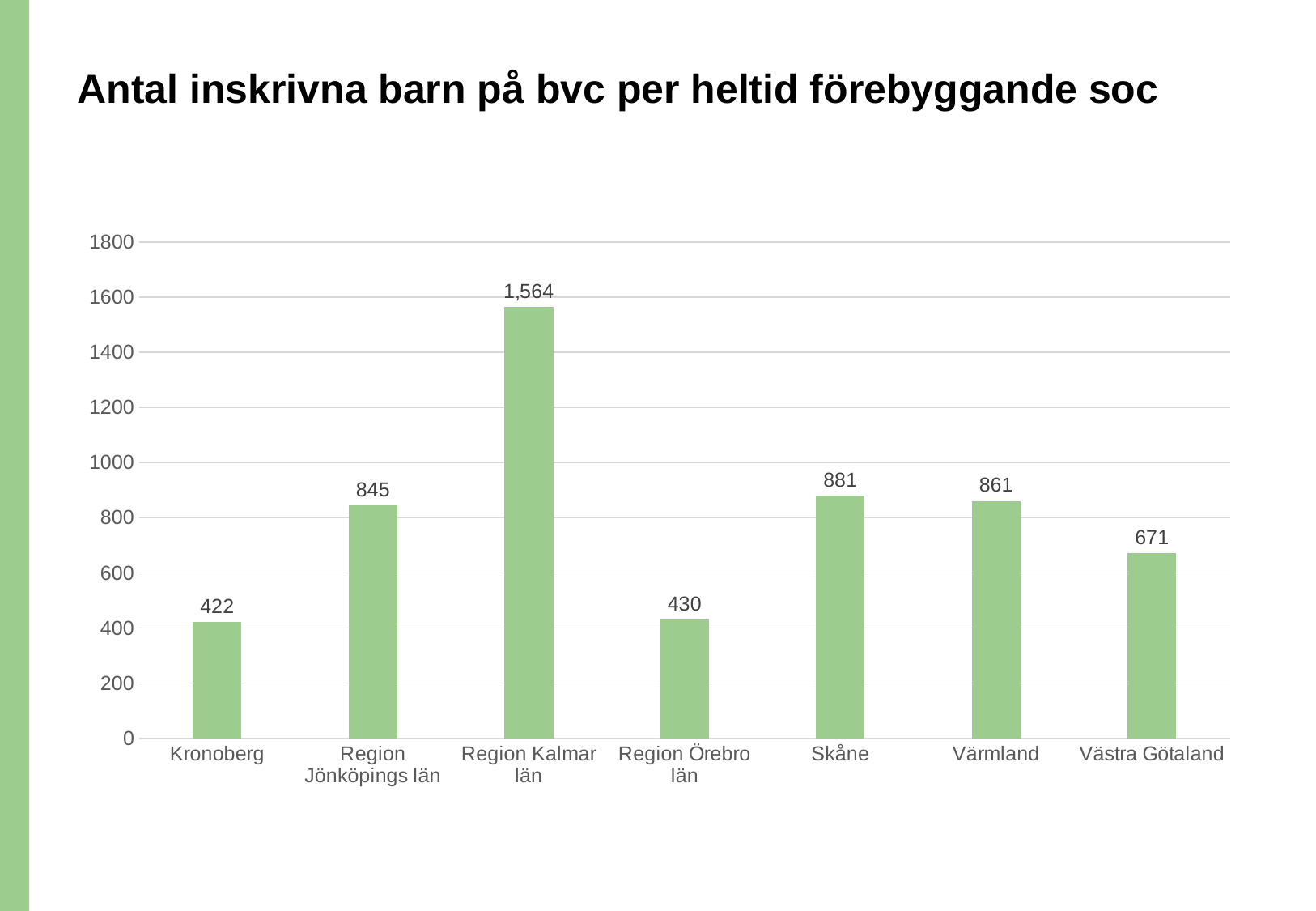
What is the value for Region Kalmar län? 1,564 Which category has the highest value? Region Kalmar län Is the value for Region Örebro län greater or less than 600? less What is the difference between the values for Skåne and Värmland? 20 Which is larger, the value for Region Jönköpings län or the value for Västra Götaland? Region Jönköpings län What is the title of the chart? Antal inskrivna barn på bvc per heltid förebyggande soc What is the value for Västra Götaland? 671 What is the value for Kronoberg? 422 Which category has the lowest value? Kronoberg What is the difference between the values for Region Kalmar län and Region Jönköpings län? 719 What kind of chart is shown on the slide? bar chart How many categories are shown on the x axis? 7